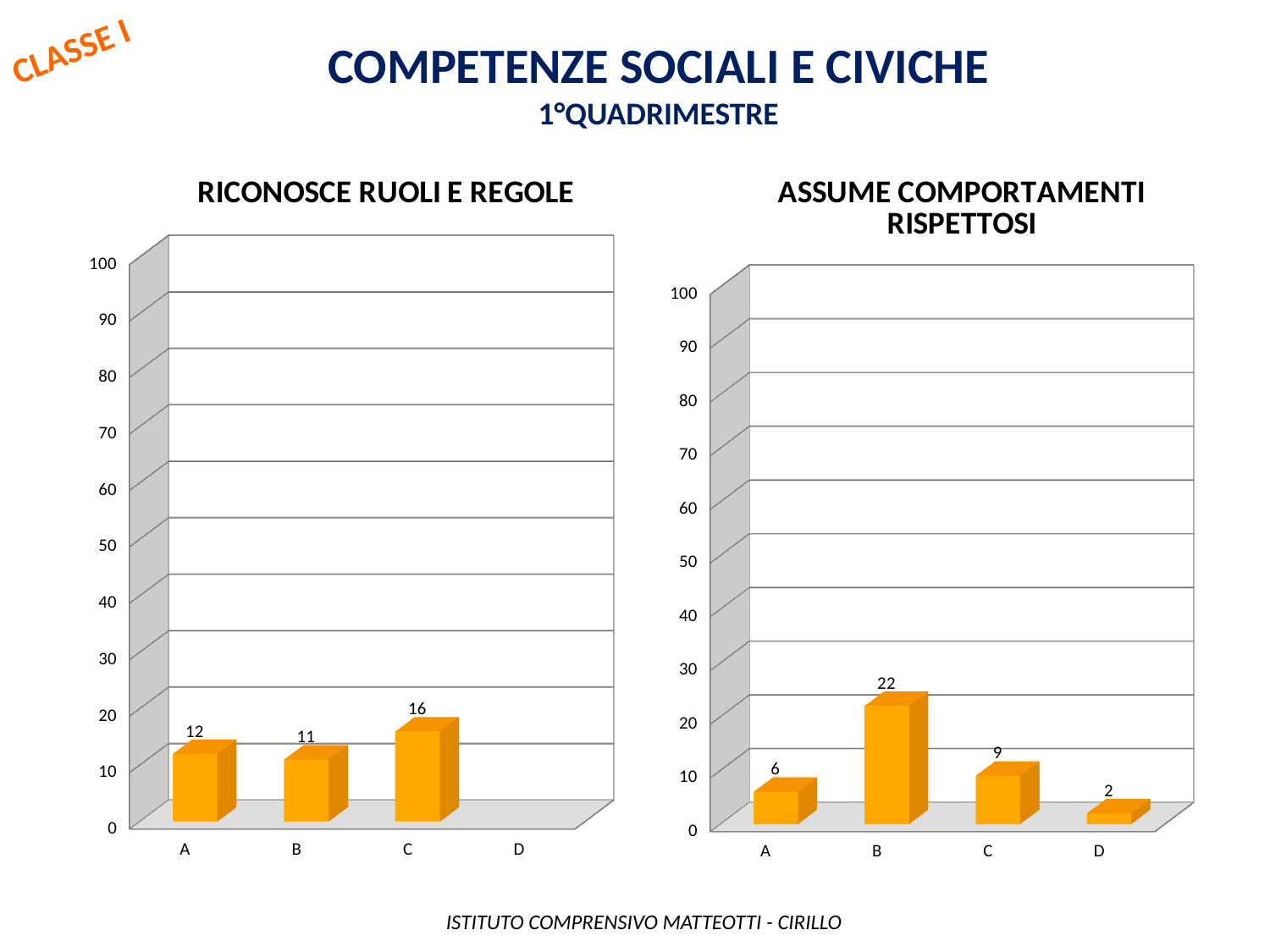
In the chart titled "RICONOSCE RUOLI E REGOLE", what is the value for category C? 16 In the chart titled "ASSUME COMPORTAMENTI RISPETTOSI", which is larger, the value for A or the value for C? C In the chart titled "ASSUME COMPORTAMENTI RISPETTOSI", which category has the lowest value? D In the chart titled "ASSUME COMPORTAMENTI RISPETTOSI", what is the value for category D? 2 How many categories are shown on the x axis of the chart titled "ASSUME COMPORTAMENTI RISPETTOSI"? 4 In the chart titled "ASSUME COMPORTAMENTI RISPETTOSI", is the value for B greater or less than 20? greater What kind of chart is the chart titled "RICONOSCE RUOLI E REGOLE"? Bar chart In the chart titled "ASSUME COMPORTAMENTI RISPETTOSI", what is the difference between the values for B and C? 13 In the chart titled "RICONOSCE RUOLI E REGOLE", what is the difference between the values for C and A? 4 In the chart titled "ASSUME COMPORTAMENTI RISPETTOSI", what is the value for category B? 22 In the chart titled "RICONOSCE RUOLI E REGOLE", which category has the highest value? C In the chart titled "RICONOSCE RUOLI E REGOLE", what is the value for category B? 11